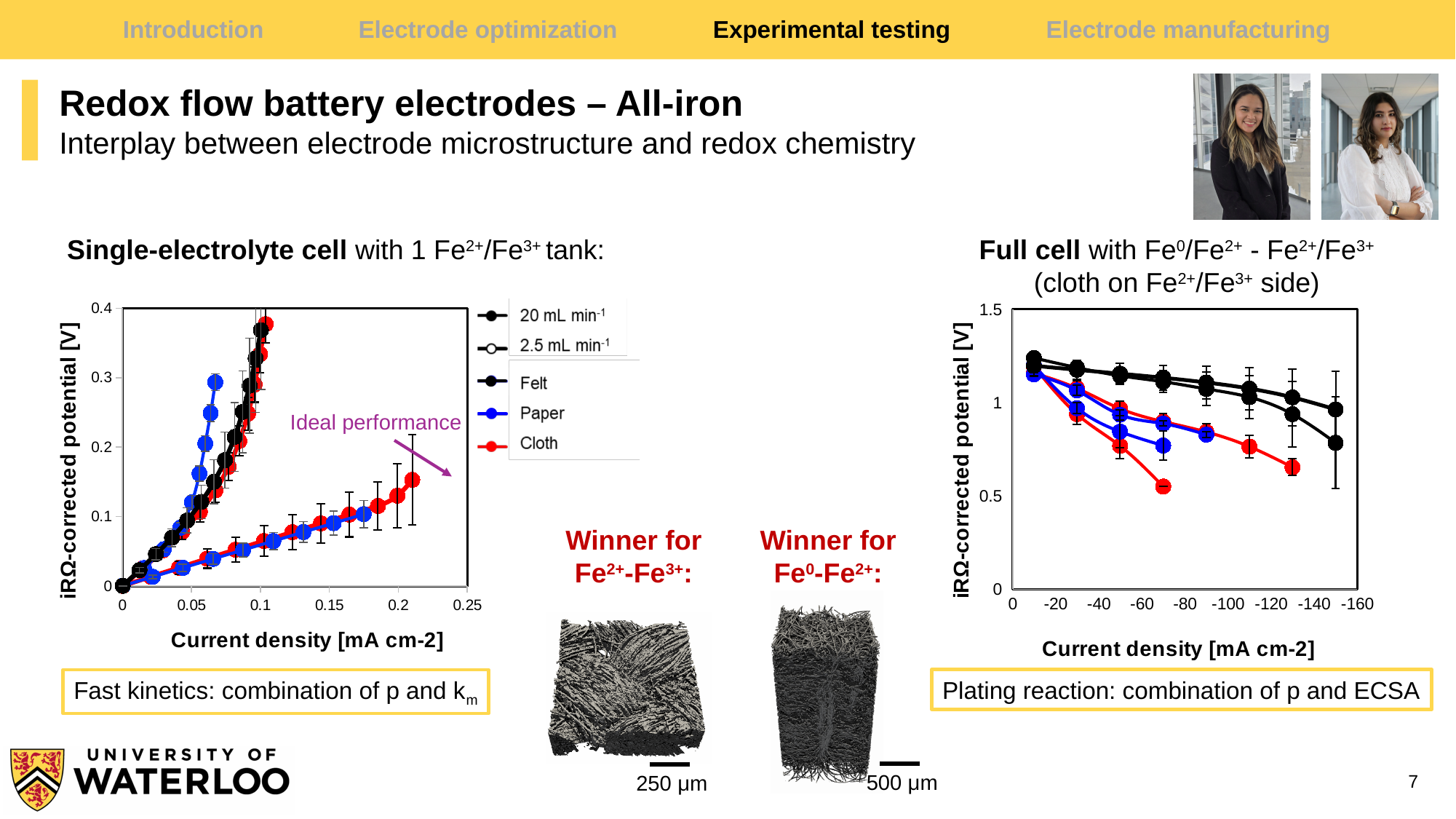
In the 'Full cell' chart on the right, do the potential values rise or fall moving from left to right along the x axis? fall In the 'Single-electrolyte cell' chart on the left, is the potential of the Cloth (red) series at a current density of about 0.2 greater or less than 0.2? less In the 'Full cell' chart on the right, is the potential of the black series at the first data point (near -10 mA cm-2) greater or less than 1? greater In the 'Single-electrolyte cell' chart on the left, is the highest potential reached by the Paper (blue) series greater or less than 0.2? greater In the 'Single-electrolyte cell' chart on the left, do the potential values rise or fall as current density increases along the x axis? rise In the 'Single-electrolyte cell' chart on the left, how many entries does the legend list? 5 In the 'Single-electrolyte cell' chart on the left, which three electrode materials are listed in the legend? Felt, Paper, Cloth What kind of chart is the 'Single-electrolyte cell' chart on the left of the slide? Line chart In the 'Single-electrolyte cell' chart on the left, what is the label of the x axis? Current density [mA cm-2] In the 'Single-electrolyte cell' chart on the left, which series extends to the highest current density on the x axis? Cloth